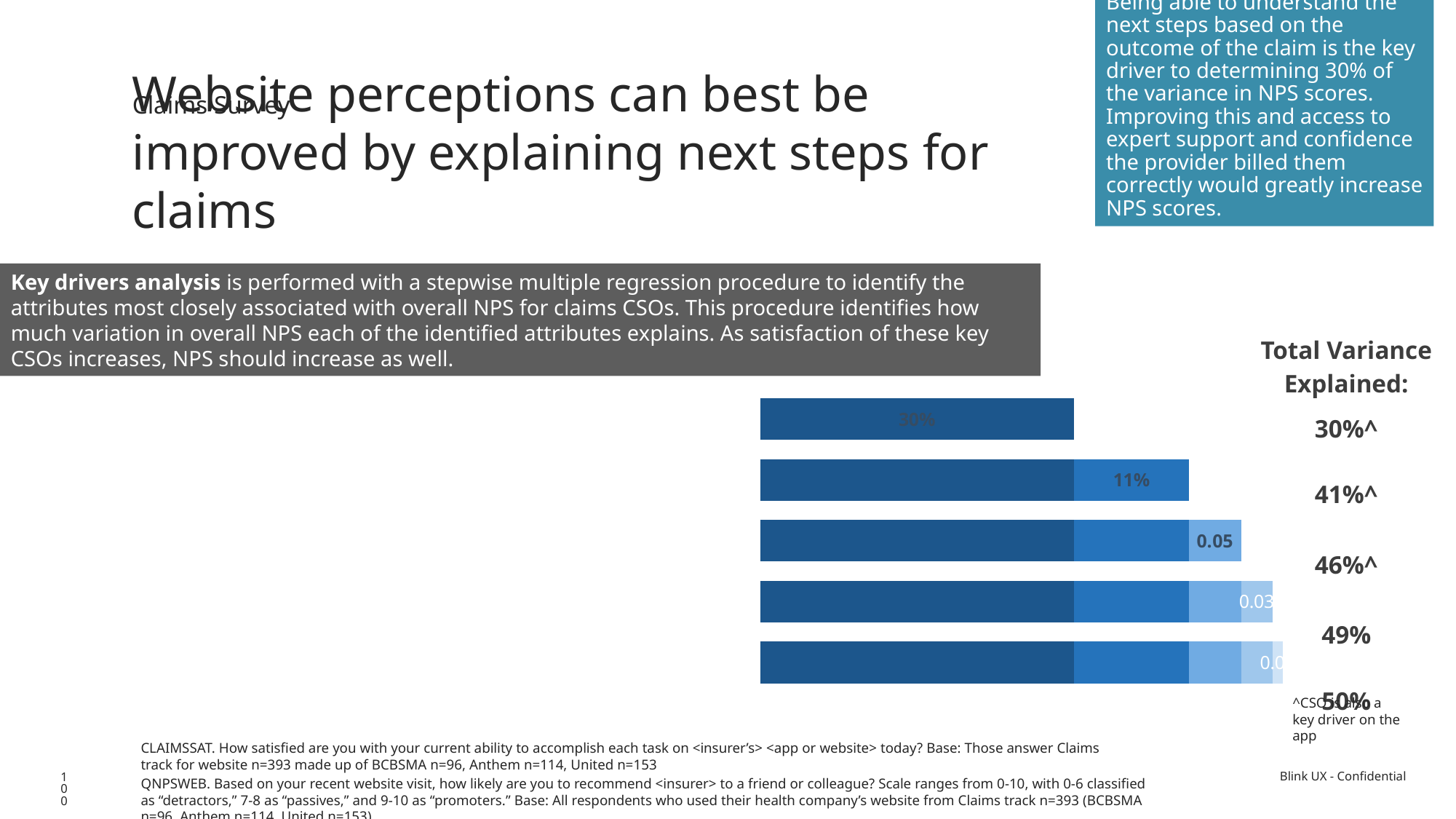
What is the data label on the added segment of the fourth bar from the top? 0.03 What is the data label on the added segment of the third bar from the top? 0.05 How many bars are plotted in the chart? 5 Which is larger, the 30% segment in the top bar or the 11% segment in the second bar? the 30% segment What is the data label on the added segment of the second bar from the top? 11% Which bar in the chart is the shortest? the top bar What is the data label on the top bar of the chart? 30% What Total Variance Explained value is listed beside the bottom bar? 50% What is the difference between the 30% label on the top bar and the 11% label on the second bar? 19% Do the bars get longer or shorter going from the top of the chart to the bottom? longer What kind of chart is shown on the slide? bar chart Which bar in the chart is the longest? the bottom bar